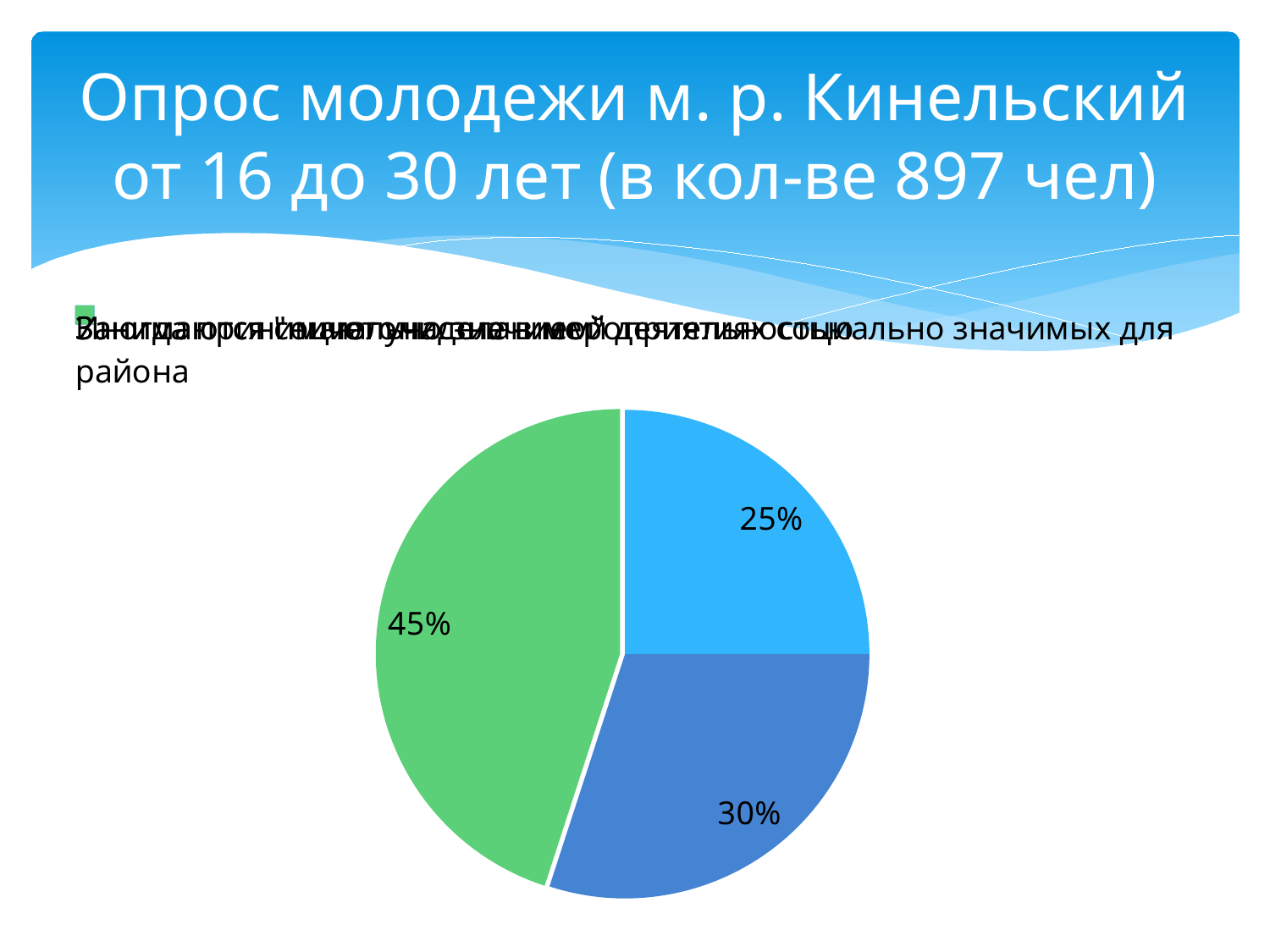
What percentage is shown on the light blue slice of the pie chart? 25% How many slices does the pie chart have? 3 Which slice is larger, the light blue one or the dark blue one? the dark blue one What colour is the largest slice of the pie chart? green What kind of chart is shown on the slide? pie chart What percentage is shown on the dark blue slice of the pie chart? 30% What is the largest share shown in the pie chart? 45% What is the difference between the largest and smallest slices of the pie chart? 20% What is the difference between the green slice and the dark blue slice of the pie chart? 15% What is the total of the three percentages shown on the pie chart? 100% What percentage is shown on the green slice of the pie chart? 45% What is the smallest share shown in the pie chart? 25%